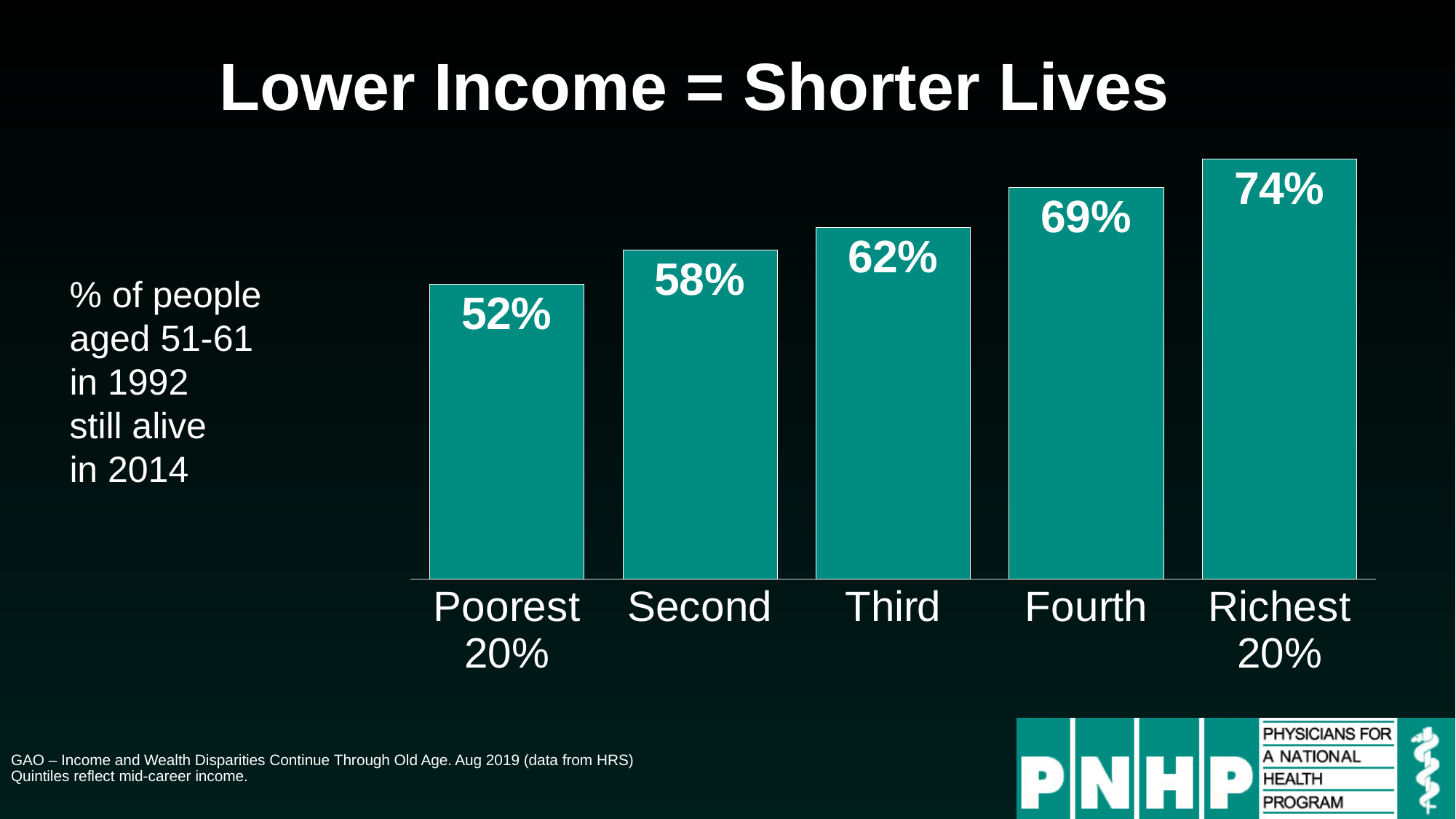
Which has a higher value, the Second quintile or the Fourth quintile? Fourth What is the value shown for the Third quintile? 62% How many income quintiles are shown in the chart? 5 Do the values rise or fall moving from the Poorest 20% to the Richest 20%? Rise Which income quintile has the lowest share of people still alive in 2014? Poorest 20% What is the difference between the values for the Richest 20% and the Poorest 20%? 22% What is the value shown for the Fourth quintile? 69% What is the title of the slide containing the chart? Lower Income = Shorter Lives What is the difference between the values for the Second and Third quintiles? 4% What kind of chart is shown on the slide? Bar chart Which income quintile has the highest share of people still alive in 2014? Richest 20% What percentage of people in the Poorest 20% income quintile were still alive in 2014? 52%